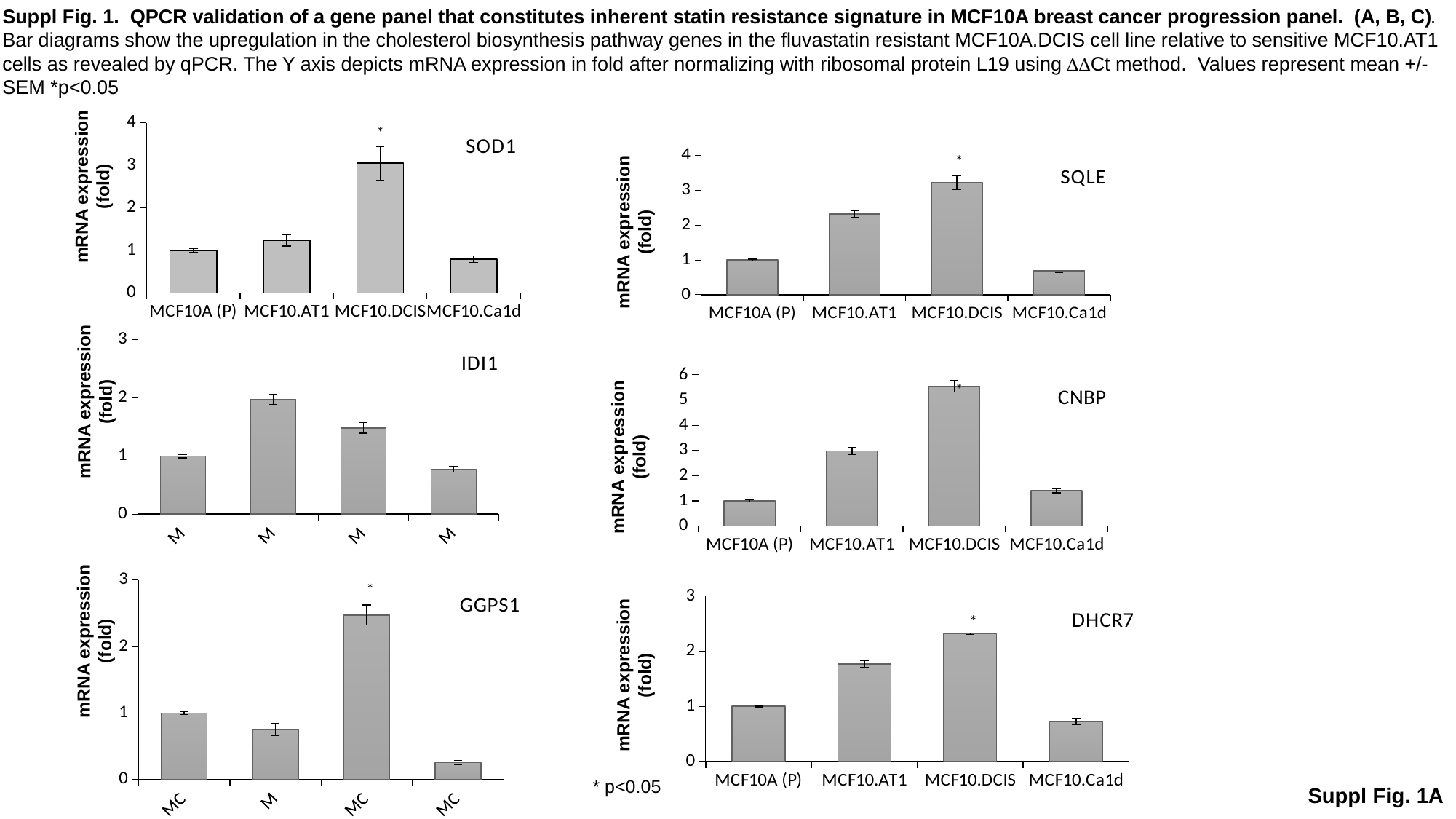
In the SQLE chart, which category has the lowest mRNA expression? MCF10.Ca1d In the CNBP chart, is the value for MCF10.DCIS greater or less than 5? greater In the DHCR7 chart, which category has the lowest mRNA expression? MCF10.Ca1d In the CNBP chart, which category has the highest mRNA expression? MCF10.DCIS In the DHCR7 chart, is the value for MCF10.DCIS greater or less than 2? greater In the SQLE chart, is the value for MCF10.AT1 greater or less than 2? greater What kind of chart is the SOD1 chart? bar chart How many bars are plotted in the GGPS1 chart? 4 How many charts are shown on the slide? 6 In the CNBP chart, which is larger, the value for MCF10.AT1 or MCF10.Ca1d? MCF10.AT1 In the SOD1 chart, which category has the highest mRNA expression? MCF10.DCIS